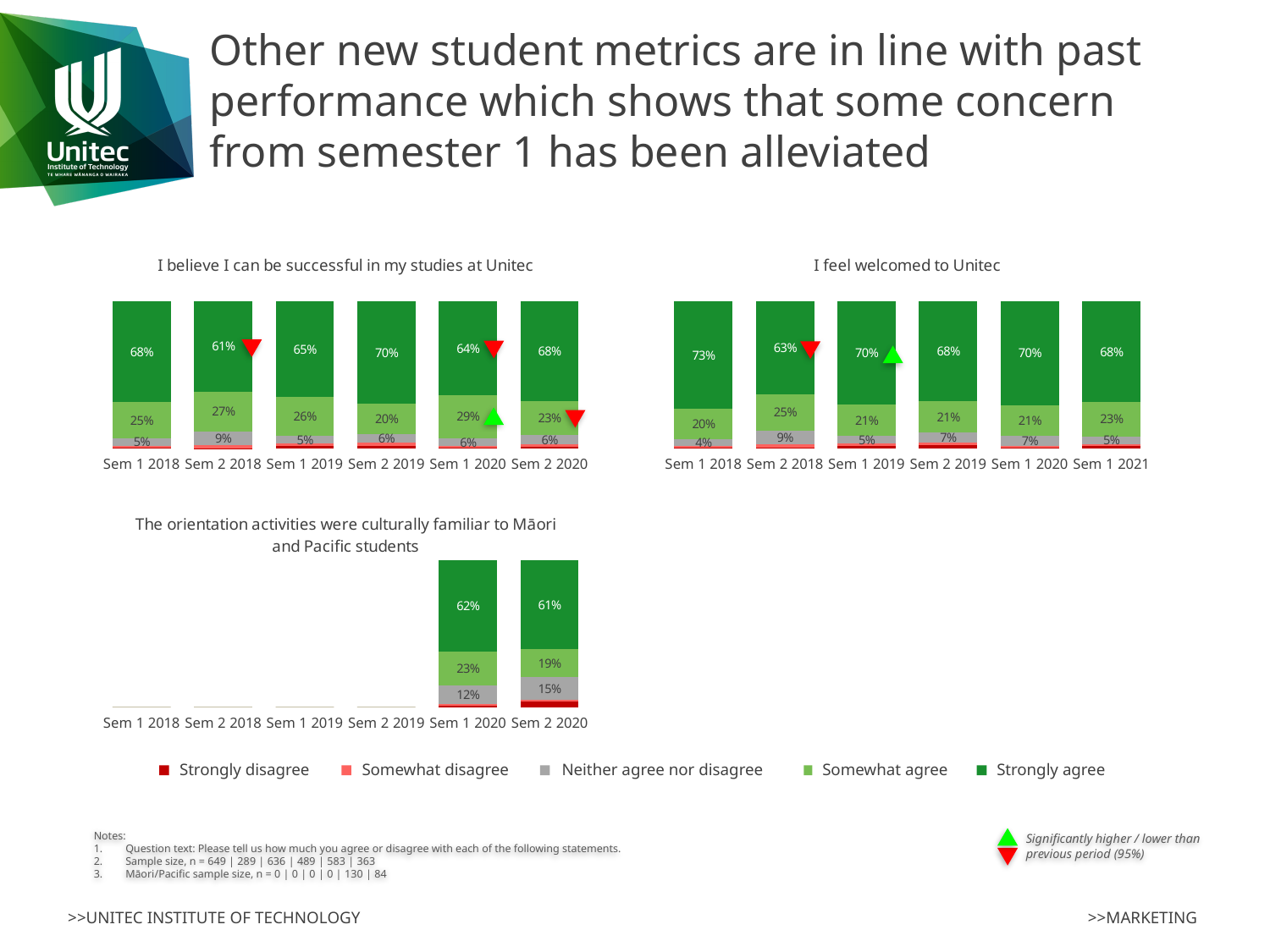
In the chart 'I believe I can be successful in my studies at Unitec', what is the Somewhat agree value for Sem 1 2020? 29% In the chart 'I believe I can be successful in my studies at Unitec', which semester has the lowest Strongly agree value? Sem 2 2018 In the chart 'I feel welcomed to Unitec', what is the difference between the Strongly agree values for Sem 1 2018 and Sem 2 2018? 10 percentage points In the chart 'The orientation activities were culturally familiar to Māori and Pacific students', what is the Neither agree nor disagree value for Sem 2 2020? 15% In the chart 'I feel welcomed to Unitec', which semester has the highest Strongly agree value? Sem 1 2018 How many semesters are shown on the x axis of the chart 'I believe I can be successful in my studies at Unitec'? 6 What kind of chart is 'I feel welcomed to Unitec'? Stacked bar chart In the chart 'I feel welcomed to Unitec', what is the Neither agree nor disagree value for Sem 2 2018? 9% In the chart 'I believe I can be successful in my studies at Unitec', what is the Strongly agree value for Sem 2 2019? 70% How many series does the legend list? 5 In the chart 'I feel welcomed to Unitec', what is the Strongly agree value for Sem 1 2018? 73% In the chart 'The orientation activities were culturally familiar to Māori and Pacific students', which is larger: the Somewhat agree value for Sem 1 2020 or for Sem 2 2020? Sem 1 2020